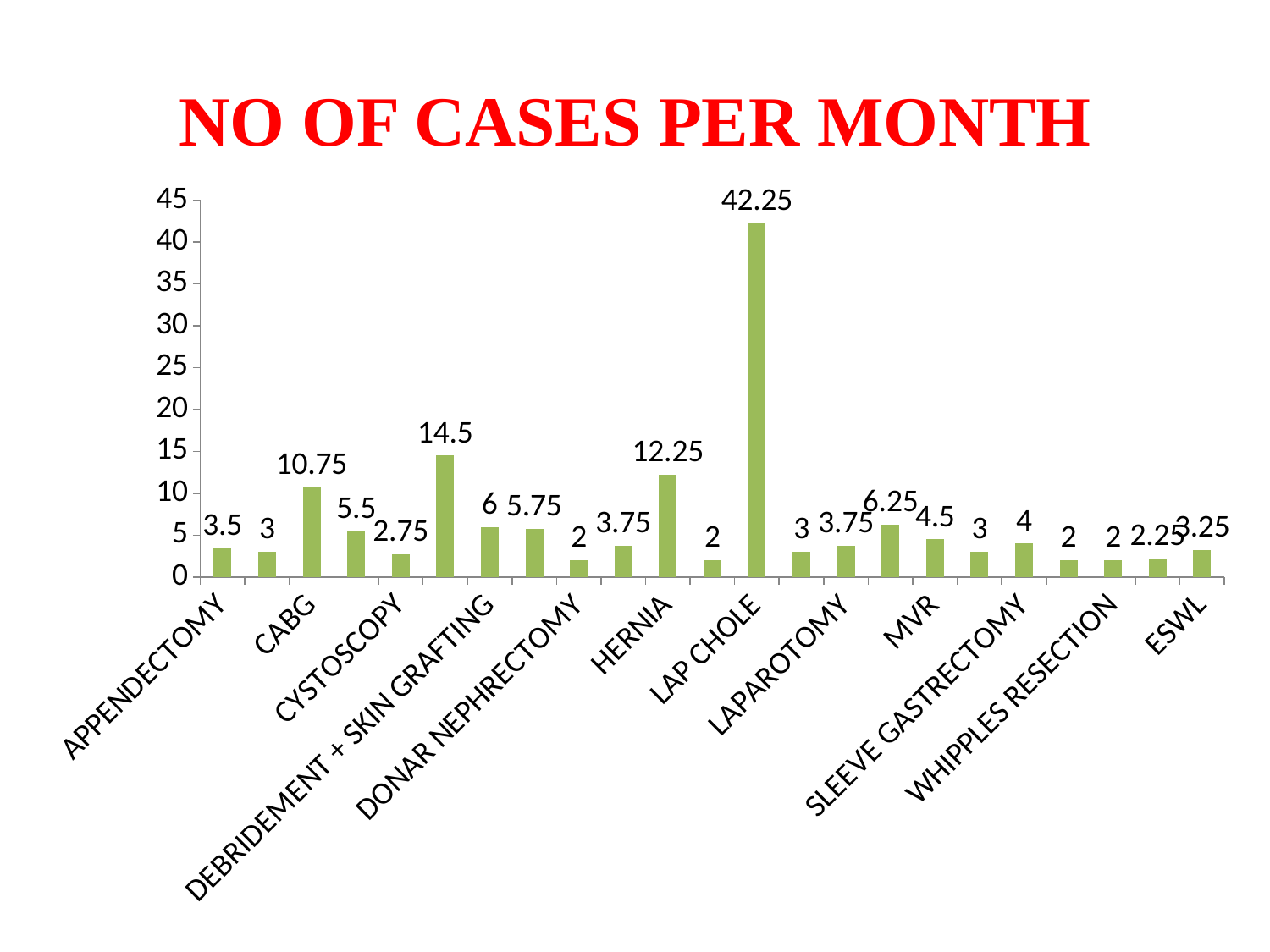
What is the difference between the values for CABG and APPENDECTOMY? 7.25 What is the value for MVR? 4.5 What is the value for APPENDECTOMY? 3.5 What is the difference between the values for LAP CHOLE and HERNIA? 30 What is the value for HERNIA? 12.25 Is the value for LAP CHOLE greater or less than 40? greater What kind of chart is shown on the slide? bar chart Which is larger, the value for CABG or the value for HERNIA? HERNIA What is the value for CABG? 10.75 Which category has the highest number of cases per month? LAP CHOLE What is the title of the chart? NO OF CASES PER MONTH What is the value for LAP CHOLE? 42.25